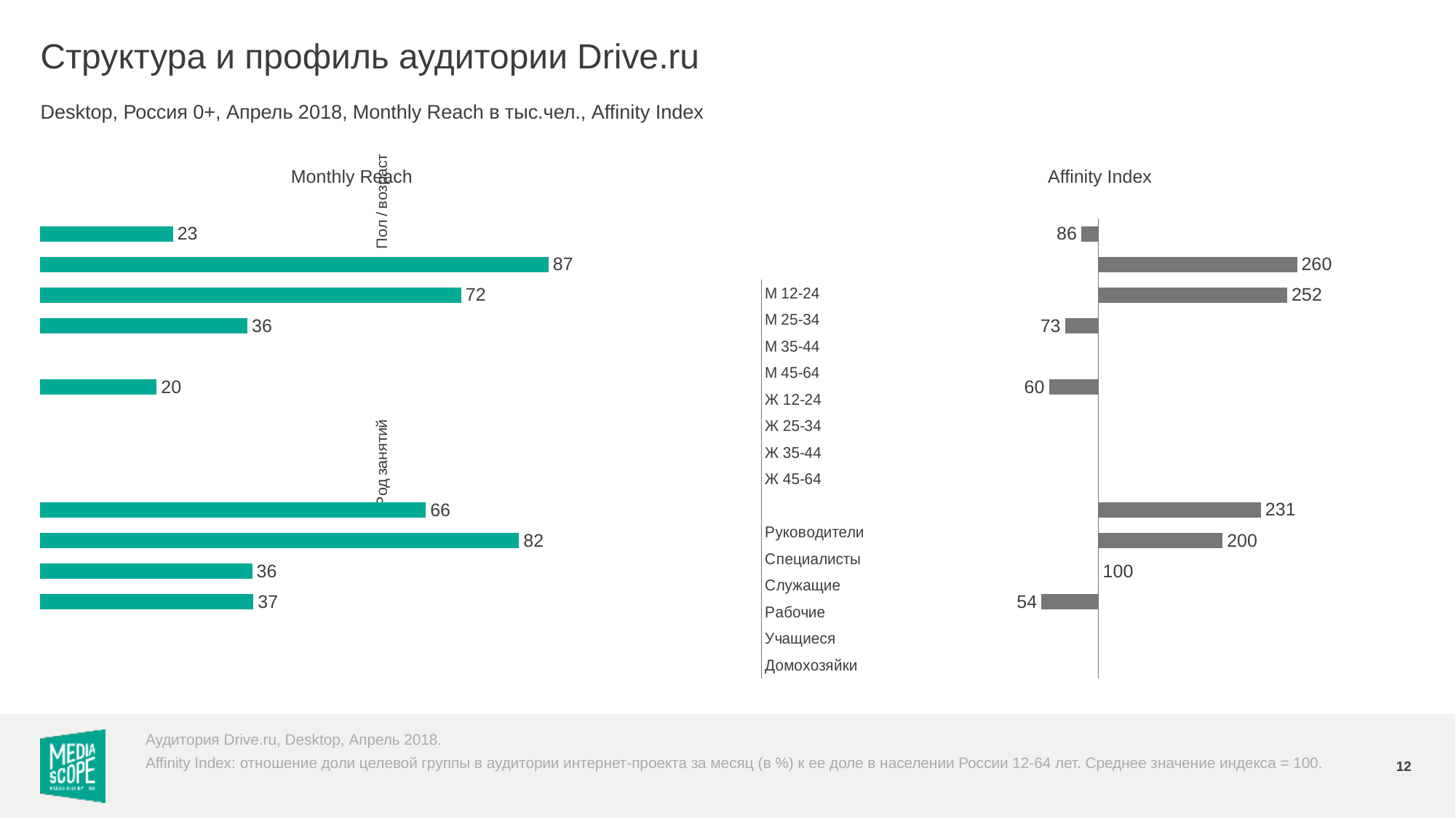
What is the title of the chart on the right side of the slide? Affinity Index What kind of chart is the Monthly Reach chart? bar chart In the Affinity Index chart, what is the highest value shown? 260 In the Affinity Index chart, what is the difference between the two largest values, 260 and 252? 8 In the Monthly Reach chart, what is the lowest value shown? 20 How many data labels are printed in the Affinity Index chart? 9 How many bars are plotted in the Monthly Reach chart? 9 In the Monthly Reach chart, what is the difference between the two largest values, 87 and 82? 5 In the Monthly Reach chart, is the topmost bar (23) longer or shorter than the bar directly below it (87)? shorter In the Affinity Index chart, what is the lowest value shown? 54 In the Affinity Index chart, what is the difference between the highest value (260) and the lowest value (54)? 206 In the Monthly Reach chart, what is the highest value shown? 87